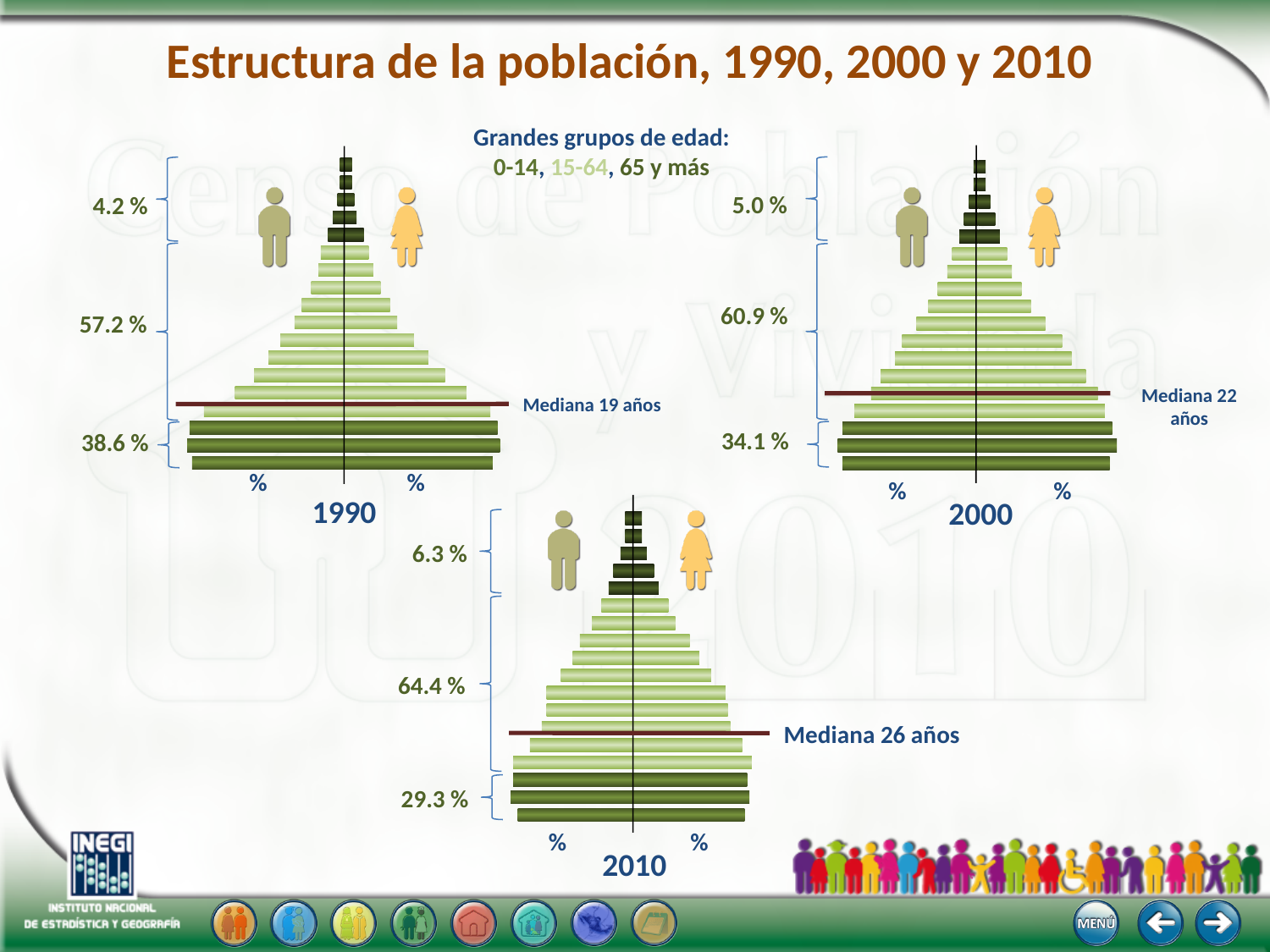
What is the median age shown for the 2000 pyramid? 22 años In the 1990 pyramid, what share of the population is in the 0-14 age group? 38.6 % How many population pyramids are shown on the slide? 3 Across the three pyramids, which year has the highest share of population aged 65 y más? 2010 Across the three pyramids, which year has the lowest share of population aged 0-14? 2010 What is the median age shown for the 2010 pyramid? 26 años Which is larger: the 0-14 share in 1990 or the 0-14 share in 2000? 1990 In the 2000 pyramid, what share of the population is in the 15-64 age group? 60.9 % In the 2010 pyramid, what share of the population is aged 65 y más? 6.3 % What kind of chart is used to show the population structure for each year? Population pyramid (bar chart) How does the share of the 0-14 age group change from 1990 to 2010? It falls What is the difference between the 15-64 share in 2010 and the 15-64 share in 1990? 7.2 %